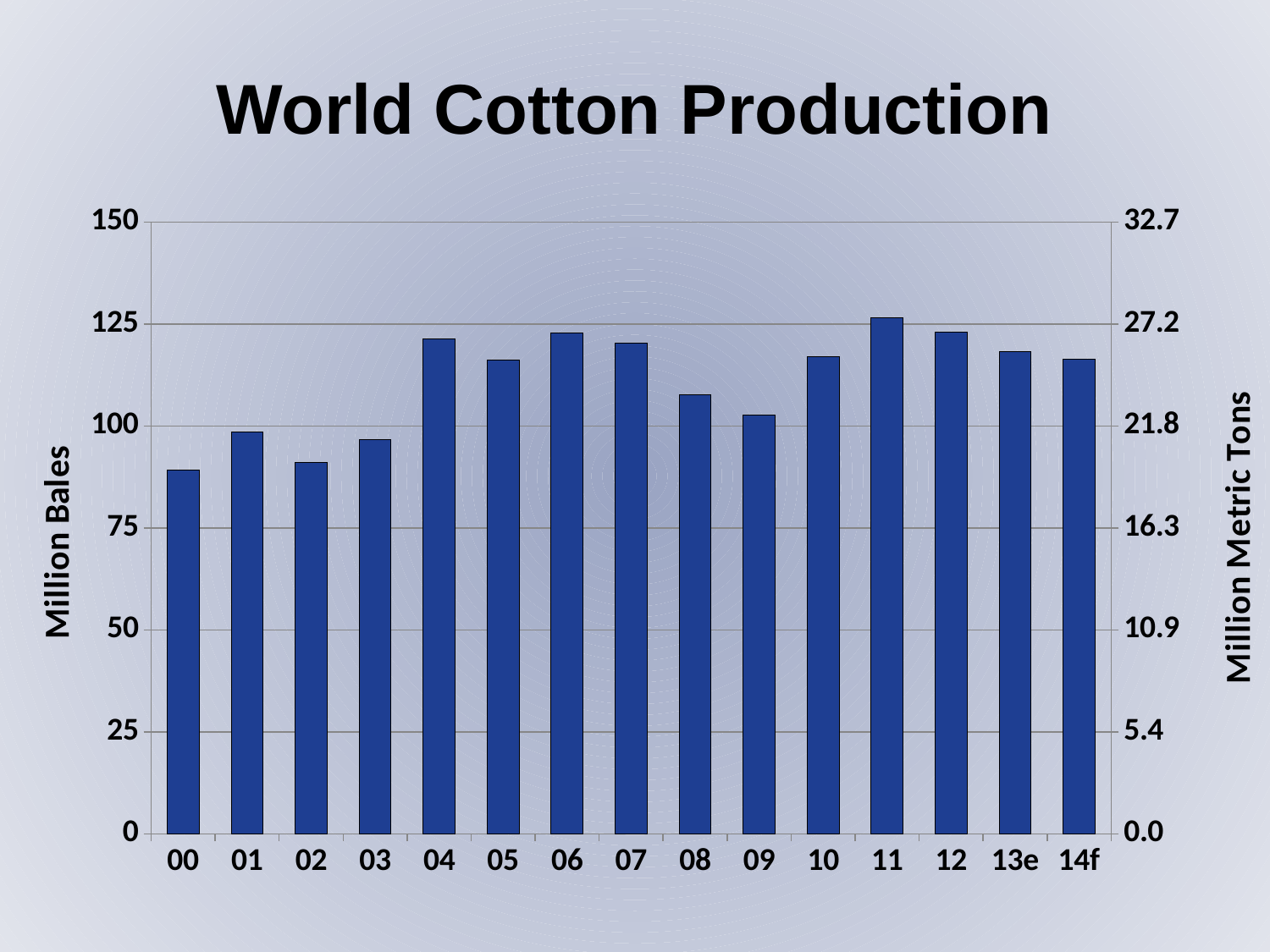
Which is larger, the value for 11 or the value for 12? 11 What is the title of the chart? World Cotton Production Is the value for 02 greater or less than 100 million bales? less Which year has the highest world cotton production? 11 Which is larger, the value for 08 or the value for 09? 08 Do the values rise or fall from 06 to 09? fall Is the value for 00 greater or less than 100 million bales? less What is the label of the left vertical axis? Million Bales Is the value for 11 greater or less than 125 million bales? greater What kind of chart is shown on the slide? bar chart How many years (bars) are shown on the x axis? 15